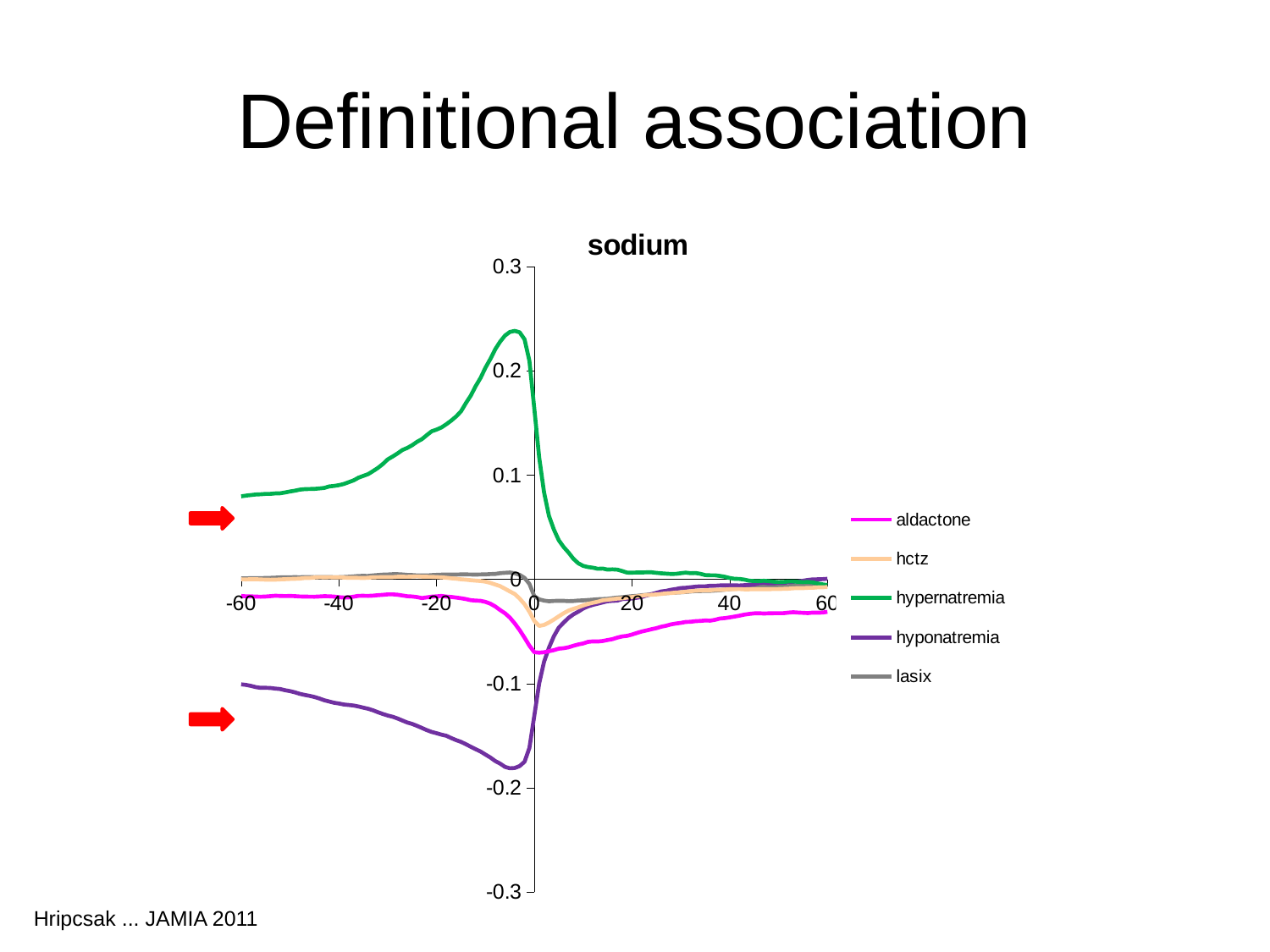
At x = 0, which series has the larger value, hypernatremia or hyponatremia? hypernatremia What kind of chart is shown on the slide? line chart How many series does the legend of the chart list? 5 Which series is drawn in green in the chart? hypernatremia Does the hypernatremia series rise or fall as x goes from 0 to 60? fall Is the lowest value of the aldactone series greater or less than -0.1? greater Is the peak value of the hypernatremia series greater or less than 0.2? greater What is the title of the chart? sodium Which series reaches the lowest value in the chart? hyponatremia Which series reaches the highest value in the chart? hypernatremia Is the lowest value of the hyponatremia series greater or less than -0.1? less